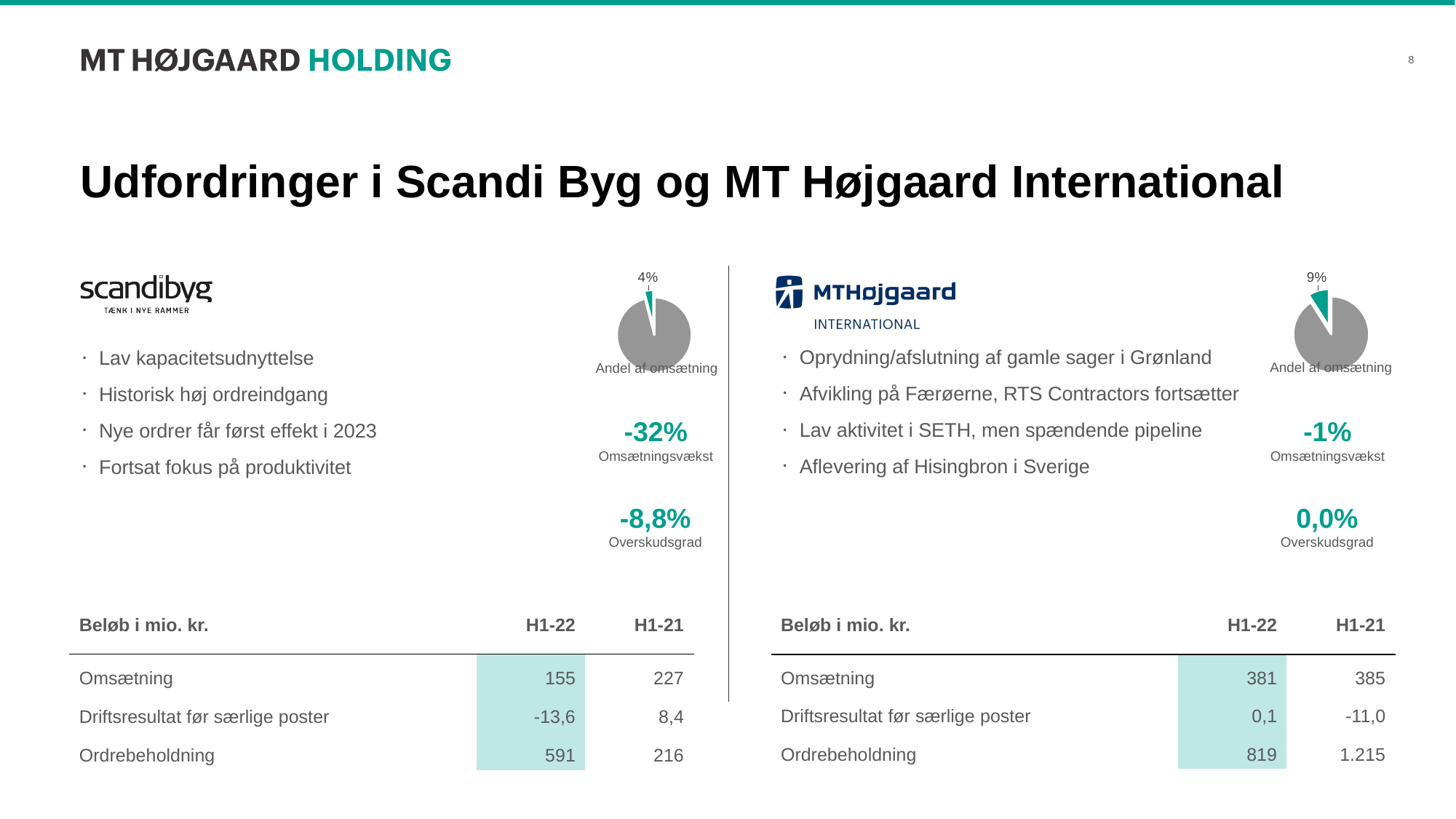
Which business unit's pie chart shows the larger highlighted share of revenue, Scandi Byg or MT Højgaard International? MT Højgaard International What colour is the highlighted slice in the pie charts on the slide? Teal (green) What type of chart is used to show 'Andel af omsætning' on the slide? Pie chart On the Scandi Byg pie chart (left), what share of revenue (Andel af omsætning) is shown by the highlighted slice? 4% On the Scandi Byg pie chart (left), is the highlighted slice larger or smaller than the grey remainder? Smaller On the MT Højgaard International pie chart (right), what share of revenue (Andel af omsætning) is shown by the highlighted slice? 9% How many slices does the Scandi Byg pie chart (left) contain? 2 What is the difference in percentage points between the highlighted share on the MT Højgaard International pie chart and the highlighted share on the Scandi Byg pie chart? 5 percentage points On the MT Højgaard International pie chart (right), what share does the grey remainder represent? 91% What caption appears beneath each pie chart on the slide? Andel af omsætning